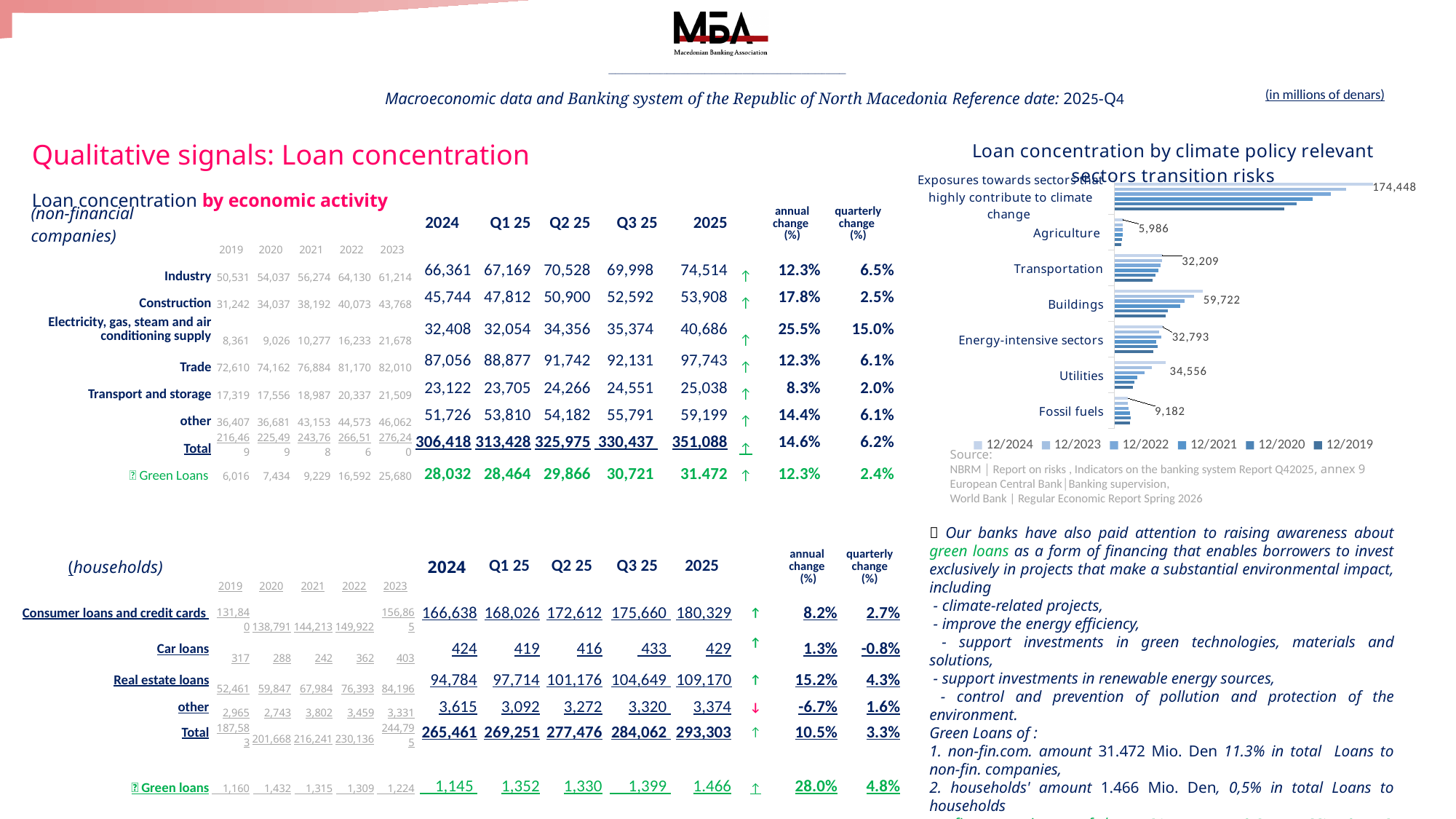
In the 'Loan concentration by climate policy relevant sectors transition risks' chart, what is the difference between the labelled values for Energy-intensive sectors and Transportation? 584 How many series does the legend of the 'Loan concentration by climate policy relevant sectors transition risks' chart list? 6 In the 'Loan concentration by climate policy relevant sectors transition risks' chart, what is the labelled value for Fossil fuels? 9,182 In the 'Loan concentration by climate policy relevant sectors transition risks' chart, which category has the lowest labelled value? Agriculture In the 'Loan concentration by climate policy relevant sectors transition risks' chart, what is the difference between the labelled values for Buildings and Utilities? 25,166 In the 'Loan concentration by climate policy relevant sectors transition risks' chart, which category has the highest labelled value? Exposures towards sectors that highly contribute to climate change In the 'Loan concentration by climate policy relevant sectors transition risks' chart, which has the larger labelled value, Buildings or Utilities? Buildings In the 'Loan concentration by climate policy relevant sectors transition risks' chart, what is the labelled value for Utilities? 34,556 In the 'Loan concentration by climate policy relevant sectors transition risks' chart, what is the labelled value for Agriculture? 5,986 What type of chart is shown under the title 'Loan concentration by climate policy relevant sectors transition risks'? bar chart How many categories are shown on the vertical axis of the 'Loan concentration by climate policy relevant sectors transition risks' chart? 7 In the 'Loan concentration by climate policy relevant sectors transition risks' chart, what is the labelled value for Buildings? 59,722